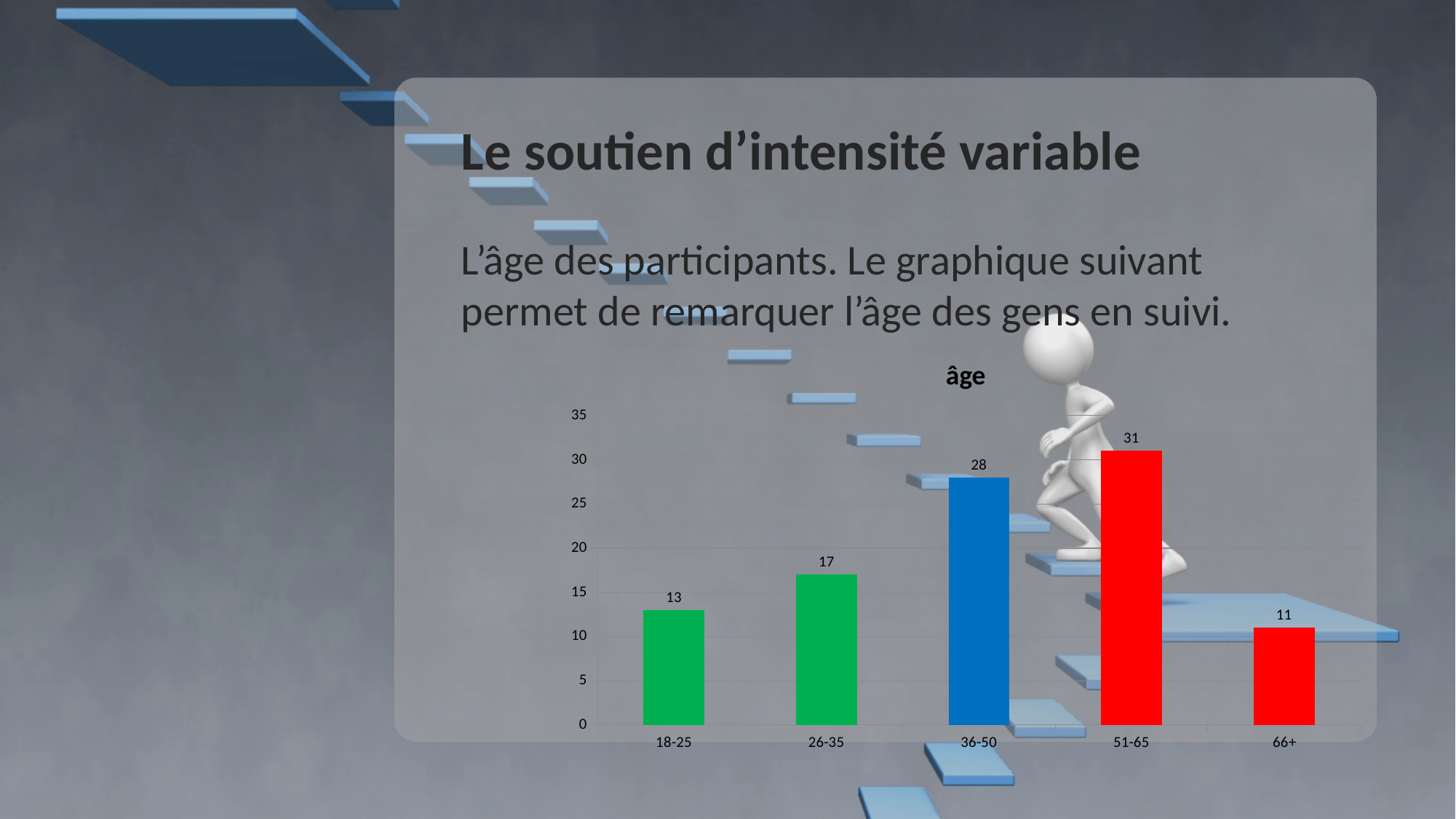
How many age groups are shown on the chart? 5 Which is larger, the value for 26-35 or the value for 66+? 26-35 What is the difference between the values for 36-50 and 18-25? 15 What is the value for the 36-50 age group? 28 What is the title of the chart? âge What is the difference between the values for 51-65 and 26-35? 14 What kind of chart is shown on the slide? bar chart What is the value for the 18-25 age group? 13 Is the value for 51-65 greater or less than 30? greater Which age group has the highest value? 51-65 What is the value for the 66+ age group? 11 Which age group has the lowest value? 66+